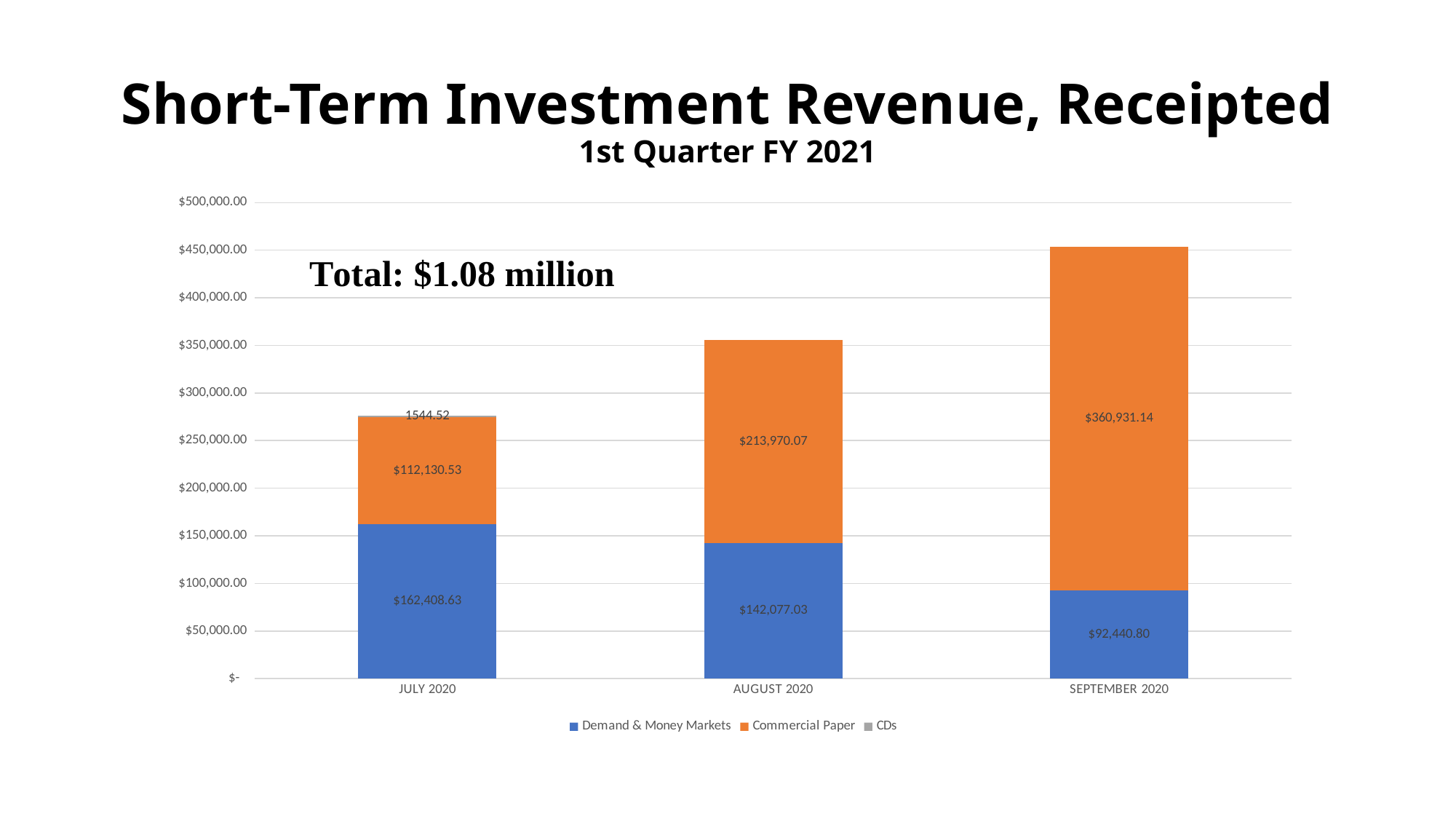
What kind of chart is shown on the slide? Stacked bar chart What is the CDs value for July 2020? 1544.52 Which month has the lowest Demand & Money Markets value? September 2020 Which month has the highest Commercial Paper value? September 2020 What is the Commercial Paper value for August 2020? $213,970.07 What is the difference between the Commercial Paper values for September 2020 and July 2020? $248,800.61 How many months are shown on the x axis? 3 What is the total of the stacked bar for July 2020? $276,083.68 How many series does the legend list? 3 What is the Demand & Money Markets value for July 2020? $162,408.63 What is the Commercial Paper value for September 2020? $360,931.14 Which is larger: Demand & Money Markets in August 2020 or Commercial Paper in August 2020? Commercial Paper